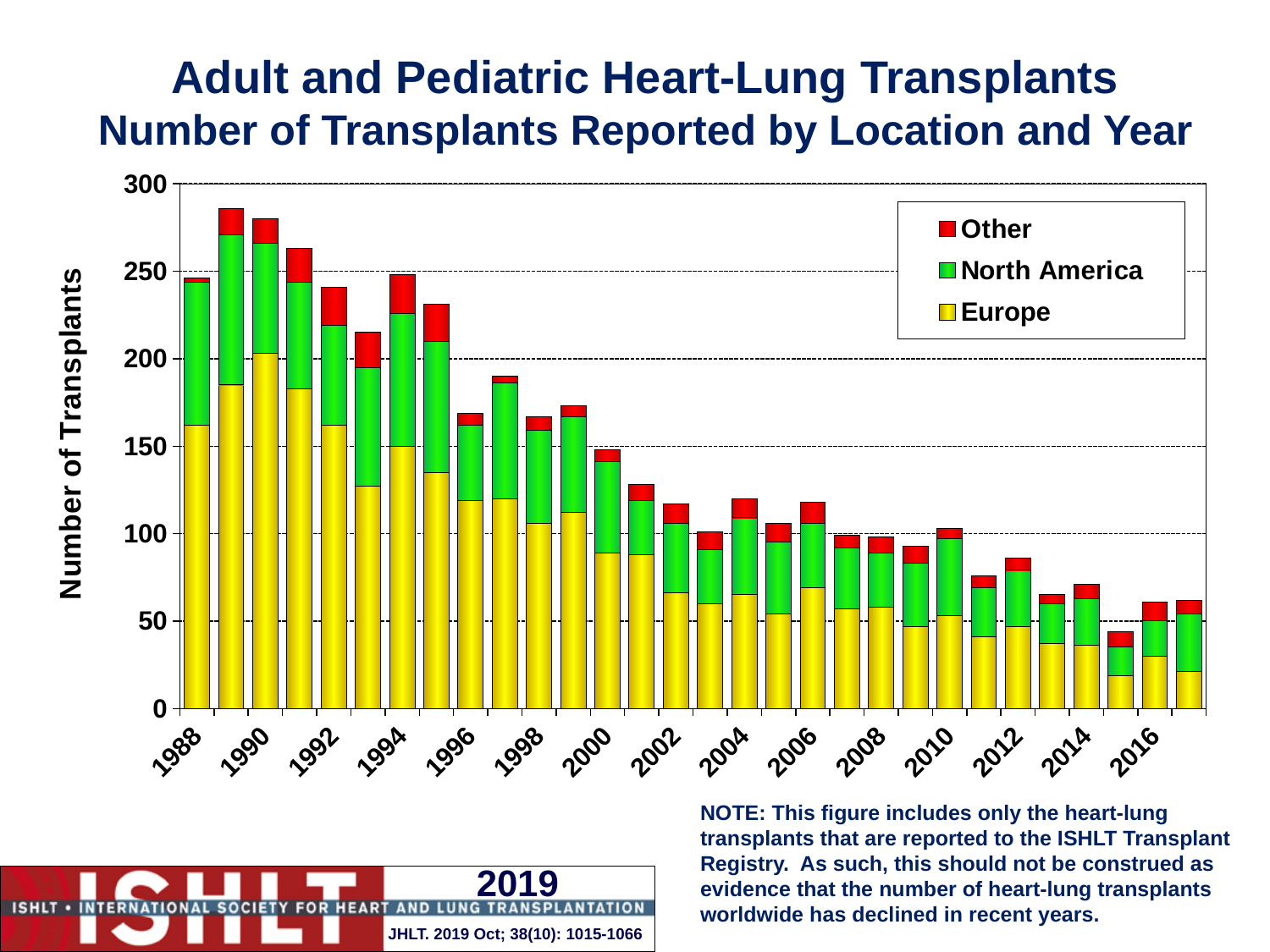
How many series does the legend list? 3 Which year has the larger total number of transplants, 1988 or 2016? 1988 What is the label of the y axis? Number of Transplants How many years (bars) are plotted in the chart? 30 Overall, do the total number of transplants rise or fall from 1988 to 2017? Fall Which series are listed in the legend? Other, North America, Europe What kind of chart is shown on the slide? Stacked bar chart Which year has the highest total number of transplants? 1989 Is the total number of transplants in 2012 greater or less than 100? less Which year has the lowest total number of transplants? 2015 Is the total number of transplants in 1988 greater or less than 200? greater Is the Europe value for 2017 greater or less than 50? less